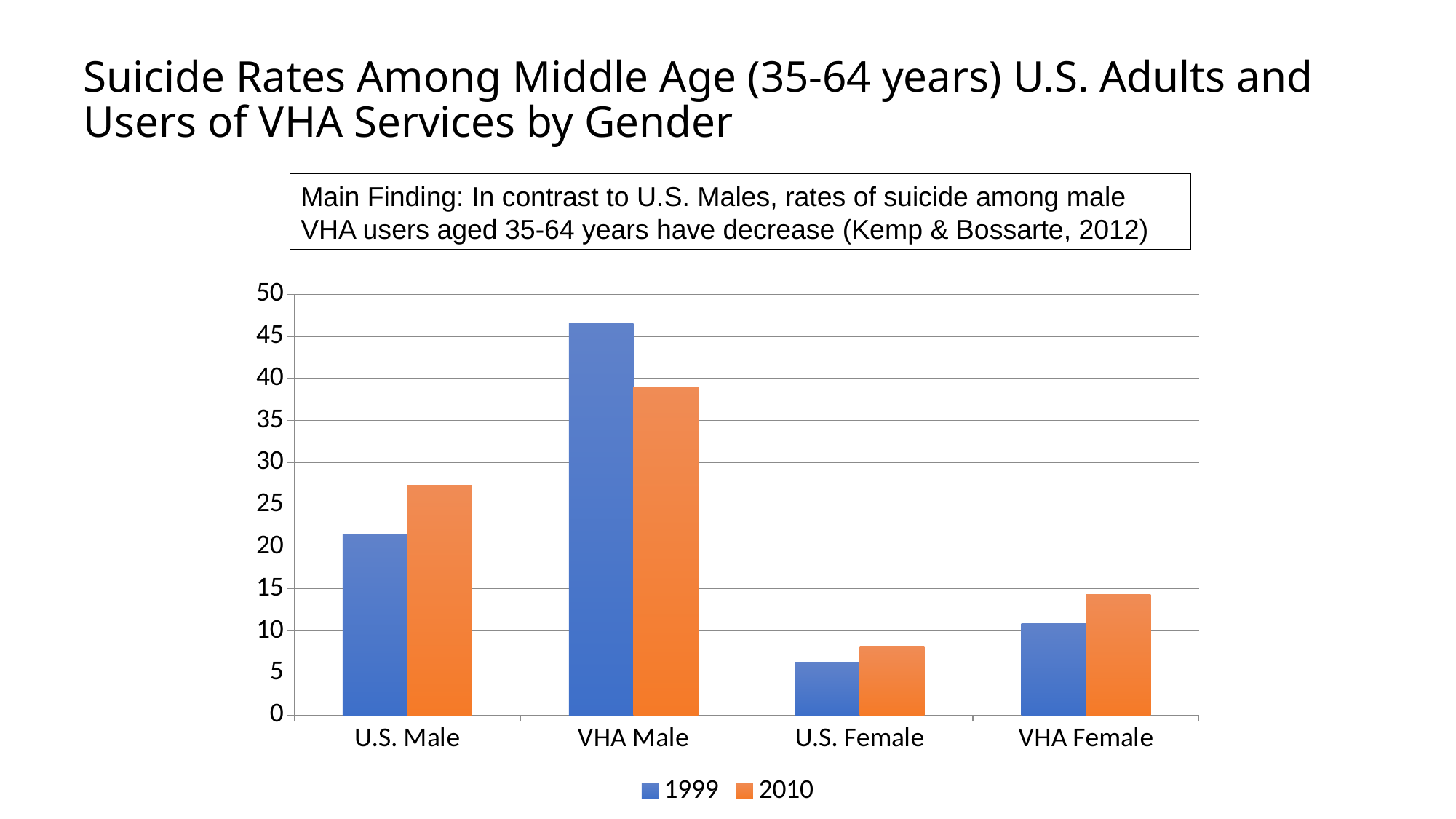
For VHA Male, which is larger: the 1999 value or the 2010 value? 1999 Which series is shown in orange in the legend? 2010 For U.S. Male, which is larger: the 1999 value or the 2010 value? 2010 Which category has the highest 1999 value? VHA Male What kind of chart is shown on the slide? bar chart How many series does the legend list? 2 How many categories are shown on the x axis? 4 Is the 1999 value for VHA Male greater or less than 45? greater Which category has the lowest 2010 value? U.S. Female Is the 2010 value for U.S. Male greater or less than 25? greater